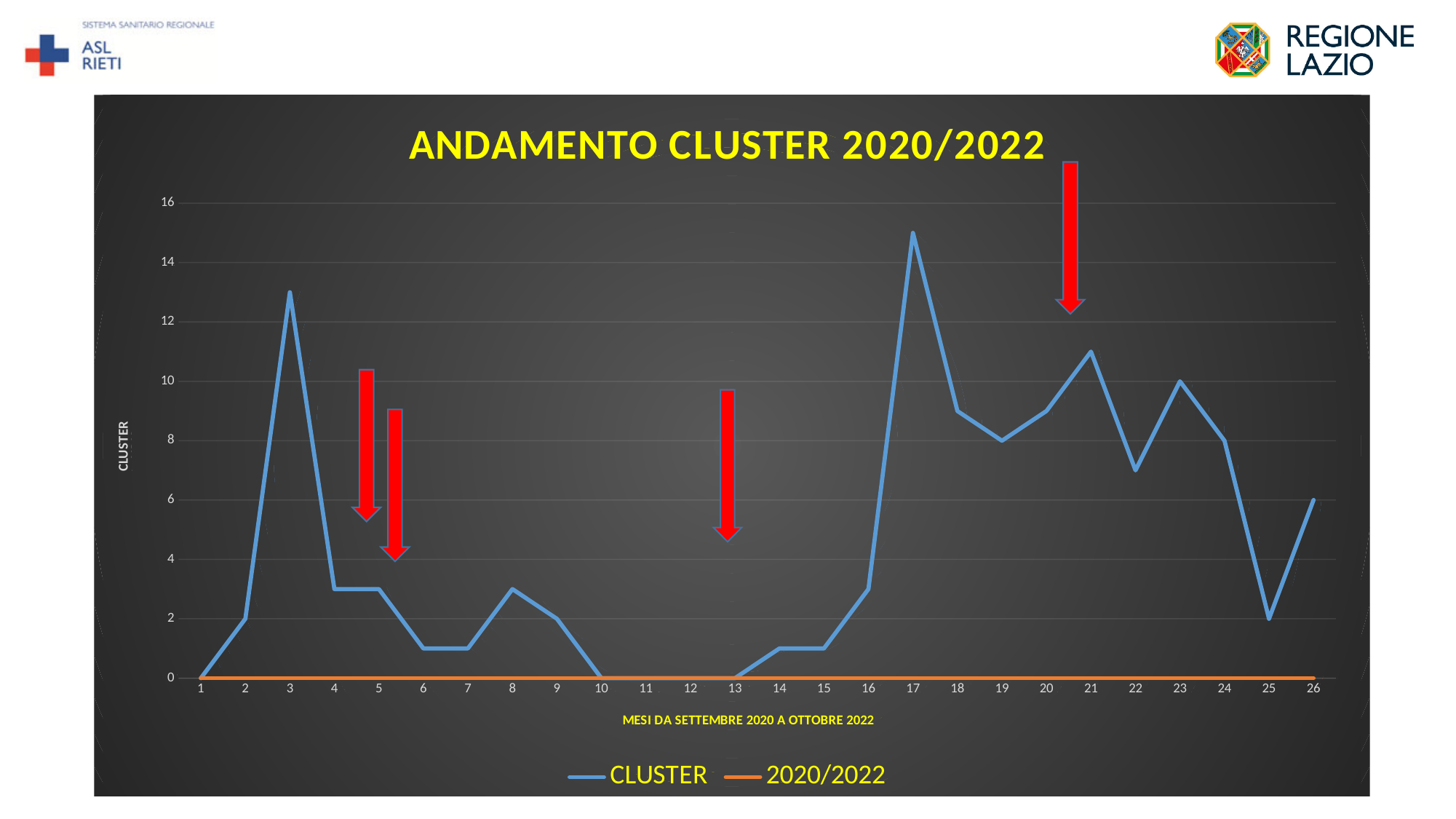
At which month does the CLUSTER series reach its highest value? 17 What is the title of the chart? ANDAMENTO CLUSTER 2020/2022 What is the CLUSTER value at month 23? 10 Is the CLUSTER value at month 3 greater or less than 12? greater What is the CLUSTER value at month 26? 6 How many months (points) are plotted along the x axis? 26 What is the CLUSTER value at month 19? 8 How many series does the legend list? 2 Is the CLUSTER value at month 22 greater or less than 8? less What kind of chart is shown on the slide? line chart Which is larger, the CLUSTER value at month 3 or at month 17? month 17 Does the CLUSTER series rise or fall from month 17 to month 19? fall